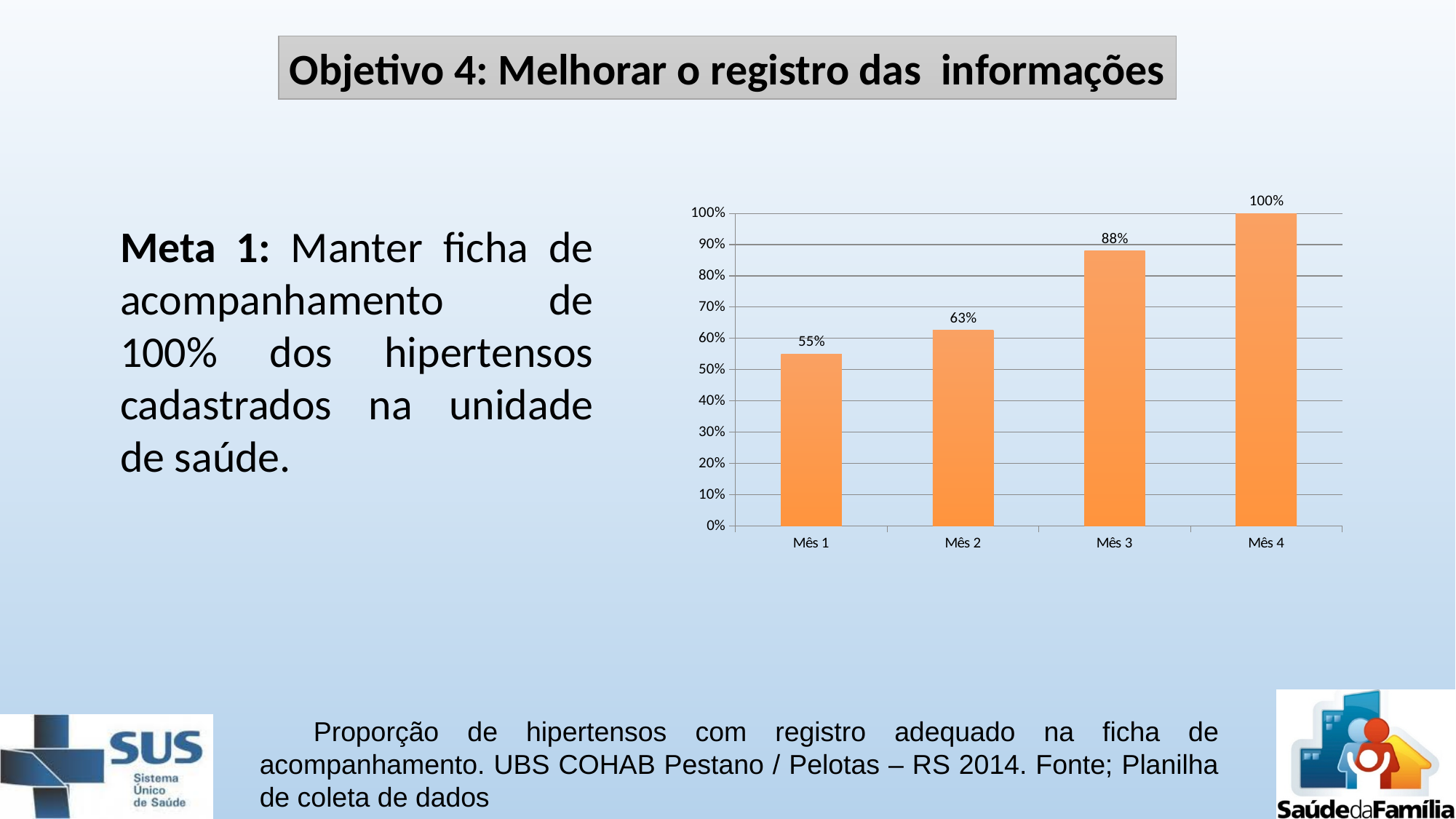
Do the values rise or fall from Mês 1 to Mês 4? Rise How many months are shown on the x axis of the chart? 4 What is the value for Mês 4? 100% What kind of chart is shown on the slide? Bar chart What is the value for Mês 3? 88% What is the difference between the values for Mês 3 and Mês 2? 25% What is the difference between the values for Mês 4 and Mês 1? 45% What is the value for Mês 2? 63% Which month has the lowest value? Mês 1 Which month has the highest value? Mês 4 Which is larger, the value for Mês 2 or the value for Mês 3? Mês 3 What is the value for Mês 1? 55%